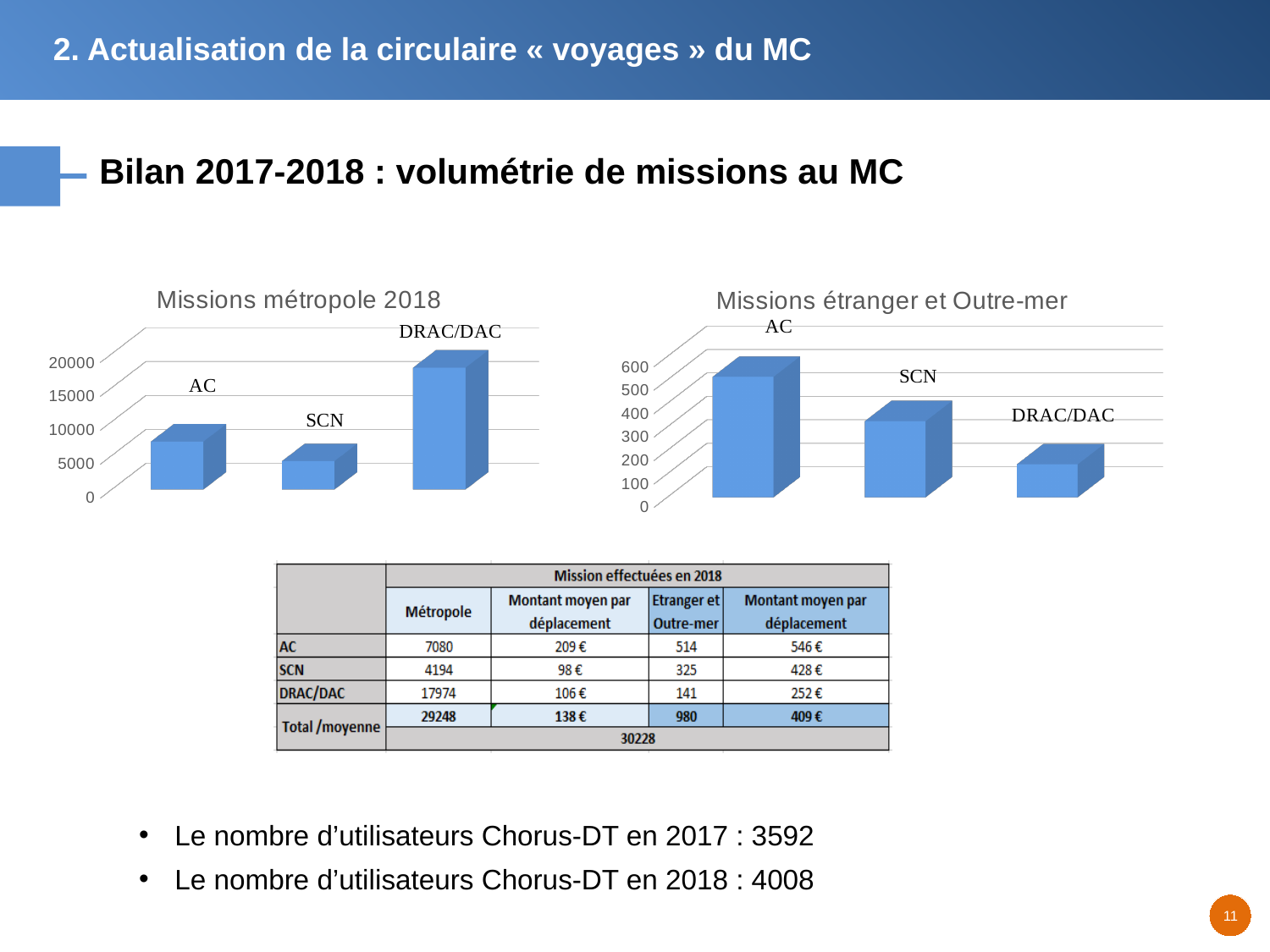
How many categories are shown in the 'Missions métropole 2018' chart? 3 In the 'Missions étranger et Outre-mer' chart, which category has the lowest value? DRAC/DAC In the 'Missions étranger et Outre-mer' chart, is the value for DRAC/DAC greater or less than 200? less In the 'Missions métropole 2018' chart, which category has the highest value? DRAC/DAC What kind of chart is the 'Missions métropole 2018' chart? bar chart In the 'Missions étranger et Outre-mer' chart, do the values rise or fall from left to right across the categories? fall In the 'Missions étranger et Outre-mer' chart, is the value for AC greater or less than 400? greater In the 'Missions métropole 2018' chart, which category has the lowest value? SCN In the 'Missions métropole 2018' chart, is the value for DRAC/DAC greater or less than 15000? greater In the 'Missions métropole 2018' chart, which is larger, AC or SCN? AC In the 'Missions étranger et Outre-mer' chart, which category has the highest value? AC